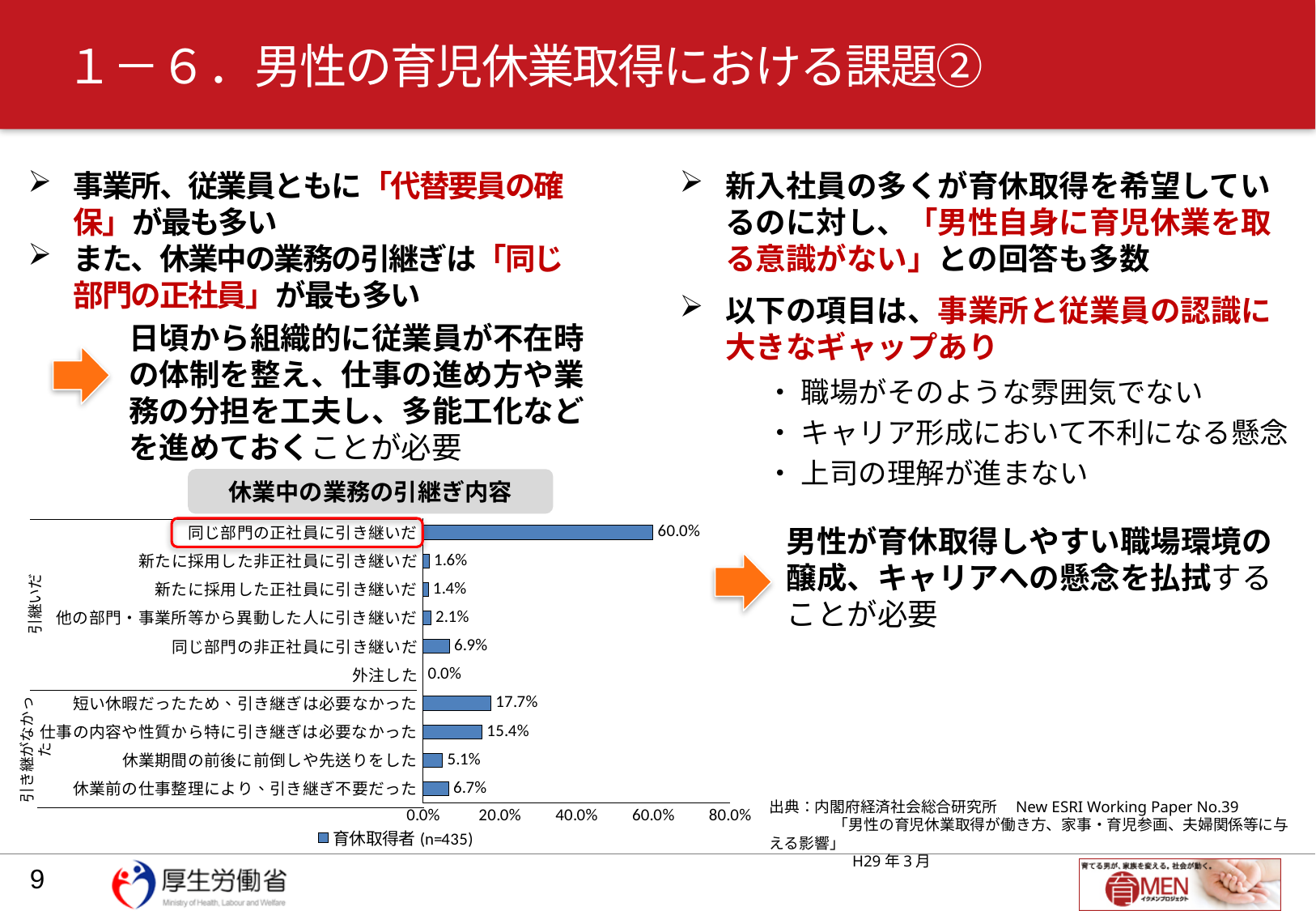
What is the value for 休業期間の前後に前倒しや先送りをした? 5.1% What is the value for 外注した? 0.0% What is the title of the chart? 休業中の業務の引継ぎ内容 Which category has the highest value? 同じ部門の正社員に引き継いだ Which category has the lowest value? 外注した What is the difference between 短い休暇だったため、引き継ぎは必要なかった and 仕事の内容や性質から特に引き継ぎは必要なかった? 2.3% What is the value for 短い休暇だったため、引き継ぎは必要なかった? 17.7% How many categories are shown in the chart? 10 What is the value for 同じ部門の正社員に引き継いだ? 60.0% Which is larger, 同じ部門の非正社員に引き継いだ or 休業前の仕事整理により、引き継ぎ不要だった? 同じ部門の非正社員に引き継いだ What type of chart is shown on the slide? bar chart How many series does the legend list? 1